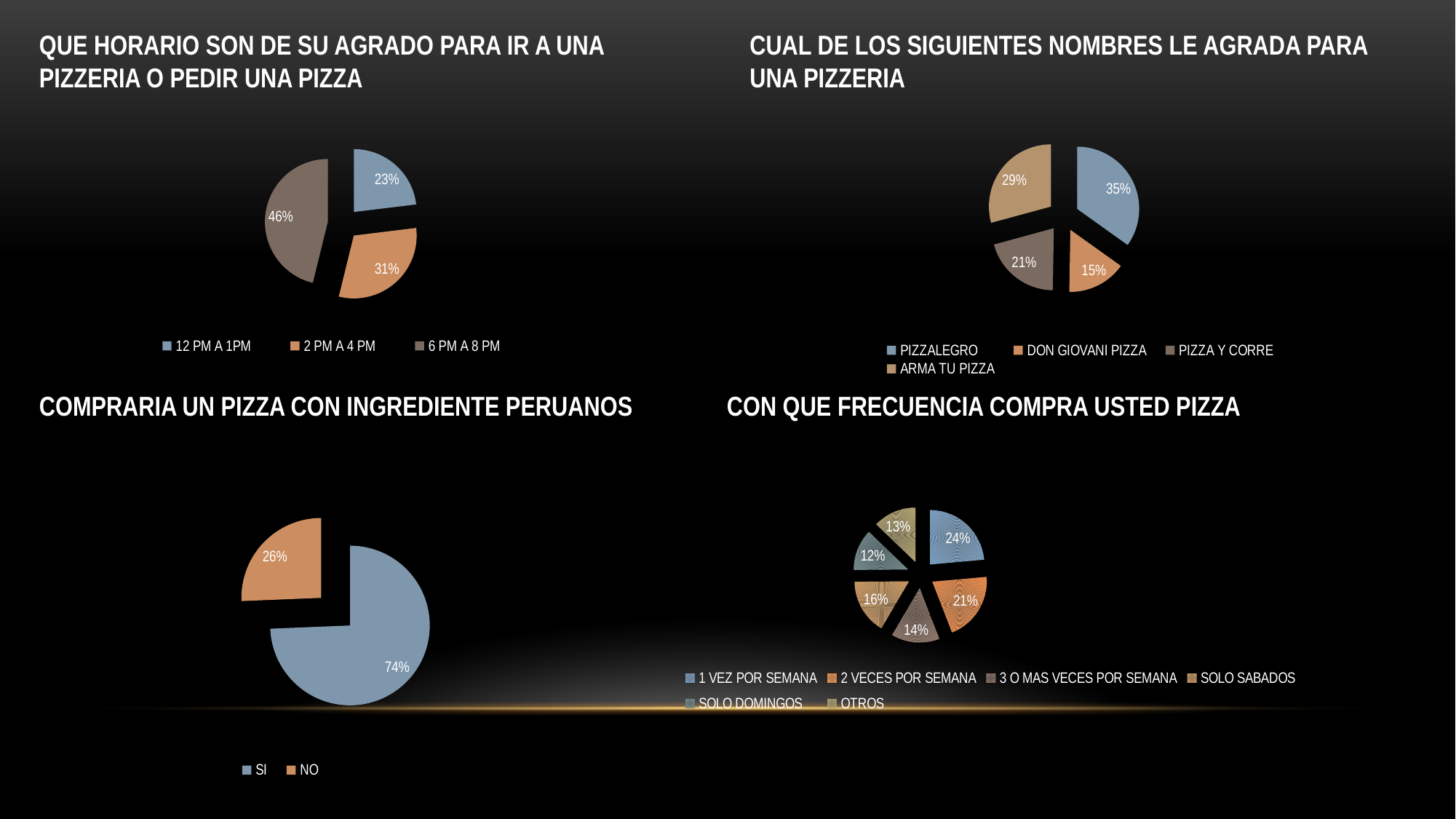
In the chart titled 'CUAL DE LOS SIGUIENTES NOMBRES LE AGRADA PARA UNA PIZZERIA', what share is shown for ARMA TU PIZZA? 29% What kind of chart is used for 'COMPRARIA UN PIZZA CON INGREDIENTE PERUANOS'? Pie chart In the chart titled 'CON QUE FRECUENCIA COMPRA USTED PIZZA', which category has the smallest share? SOLO DOMINGOS In the chart titled 'QUE HORARIO SON DE SU AGRADO PARA IR A UNA PIZZERIA O PEDIR UNA PIZZA', which time slot has the smallest share? 12 PM A 1PM In the chart titled 'CON QUE FRECUENCIA COMPRA USTED PIZZA', how many categories does the legend list? 6 In the chart titled 'QUE HORARIO SON DE SU AGRADO PARA IR A UNA PIZZERIA O PEDIR UNA PIZZA', what is the difference between the shares for 6 PM A 8 PM and 2 PM A 4 PM? 15% In the chart titled 'CON QUE FRECUENCIA COMPRA USTED PIZZA', what share is shown for SOLO SABADOS? 16% In the chart titled 'COMPRARIA UN PIZZA CON INGREDIENTE PERUANOS', what share answered SI? 74% In the chart titled 'QUE HORARIO SON DE SU AGRADO PARA IR A UNA PIZZERIA O PEDIR UNA PIZZA', what share is shown for 6 PM A 8 PM? 46% In the chart titled 'CUAL DE LOS SIGUIENTES NOMBRES LE AGRADA PARA UNA PIZZERIA', which name has the largest share? PIZZALEGRO In the chart titled 'CUAL DE LOS SIGUIENTES NOMBRES LE AGRADA PARA UNA PIZZERIA', how many names are listed in the legend? 4 In the chart titled 'CUAL DE LOS SIGUIENTES NOMBRES LE AGRADA PARA UNA PIZZERIA', which has a larger share, DON GIOVANI PIZZA or PIZZA Y CORRE? PIZZA Y CORRE